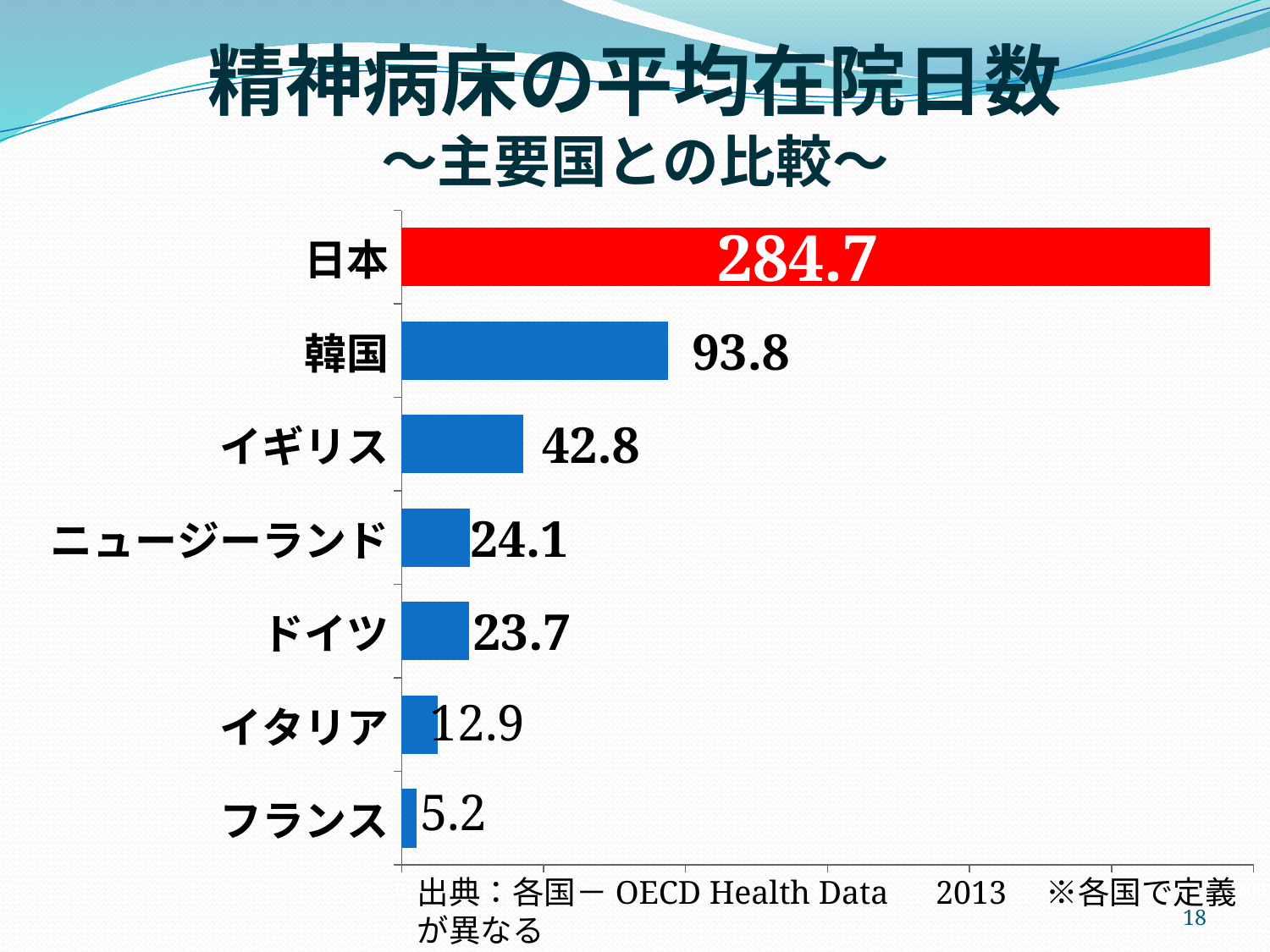
What is the difference between the values for イギリス and イタリア? 29.9 What is the difference between the values for 日本 and 韓国? 190.9 What is the value for 韓国 (South Korea)? 93.8 What is the value for フランス (France)? 5.2 What is the value for イギリス (UK)? 42.8 What is the value for 日本 (Japan)? 284.7 Which bar is coloured red rather than blue? 日本 What kind of chart is shown on the slide? Bar chart How many countries are shown in the chart? 7 Which country has the highest value? 日本 Which country has the lowest value? フランス Which is larger, the value for ニュージーランド or the value for ドイツ? ニュージーランド